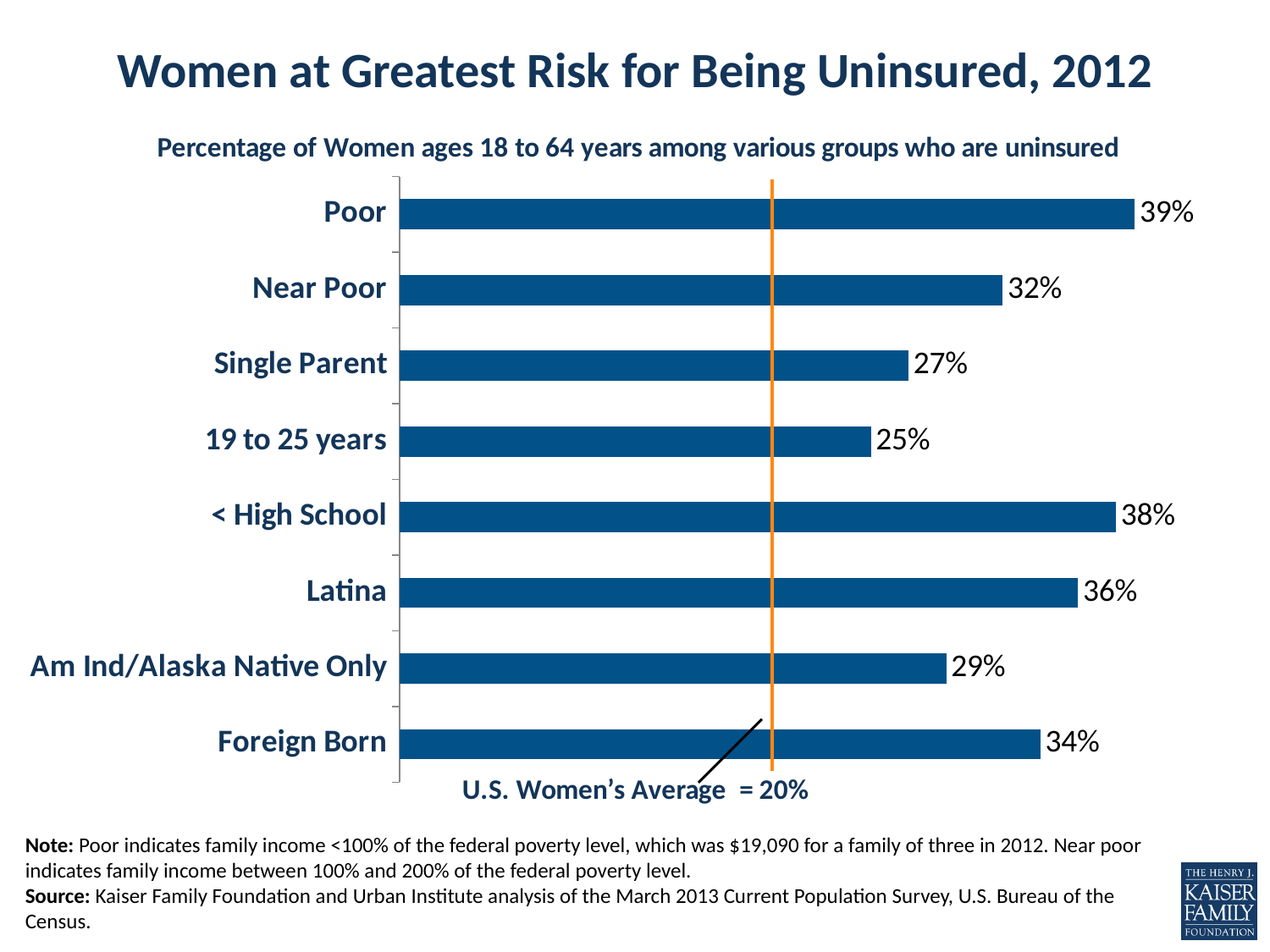
Which group has the lowest uninsured rate on the chart? 19 to 25 years How much higher is the uninsured rate for Foreign Born women than for Single Parent women? 7% What percentage of poor women ages 18 to 64 are uninsured? 39% What is the subtitle of the chart? Percentage of Women ages 18 to 64 years among various groups who are uninsured What is the difference in uninsured rate between Poor and Near Poor women? 7% What value is shown for women aged 19 to 25 years? 25% What is the U.S. women's average uninsured rate marked by the vertical line? 20% What is the uninsured rate shown for Latina women? 36% Which group has the highest uninsured rate on the chart? Poor How many groups are shown on the chart? 8 Which has a higher uninsured rate, < High School or Am Ind/Alaska Native Only? < High School What kind of chart is shown on the slide? Bar chart